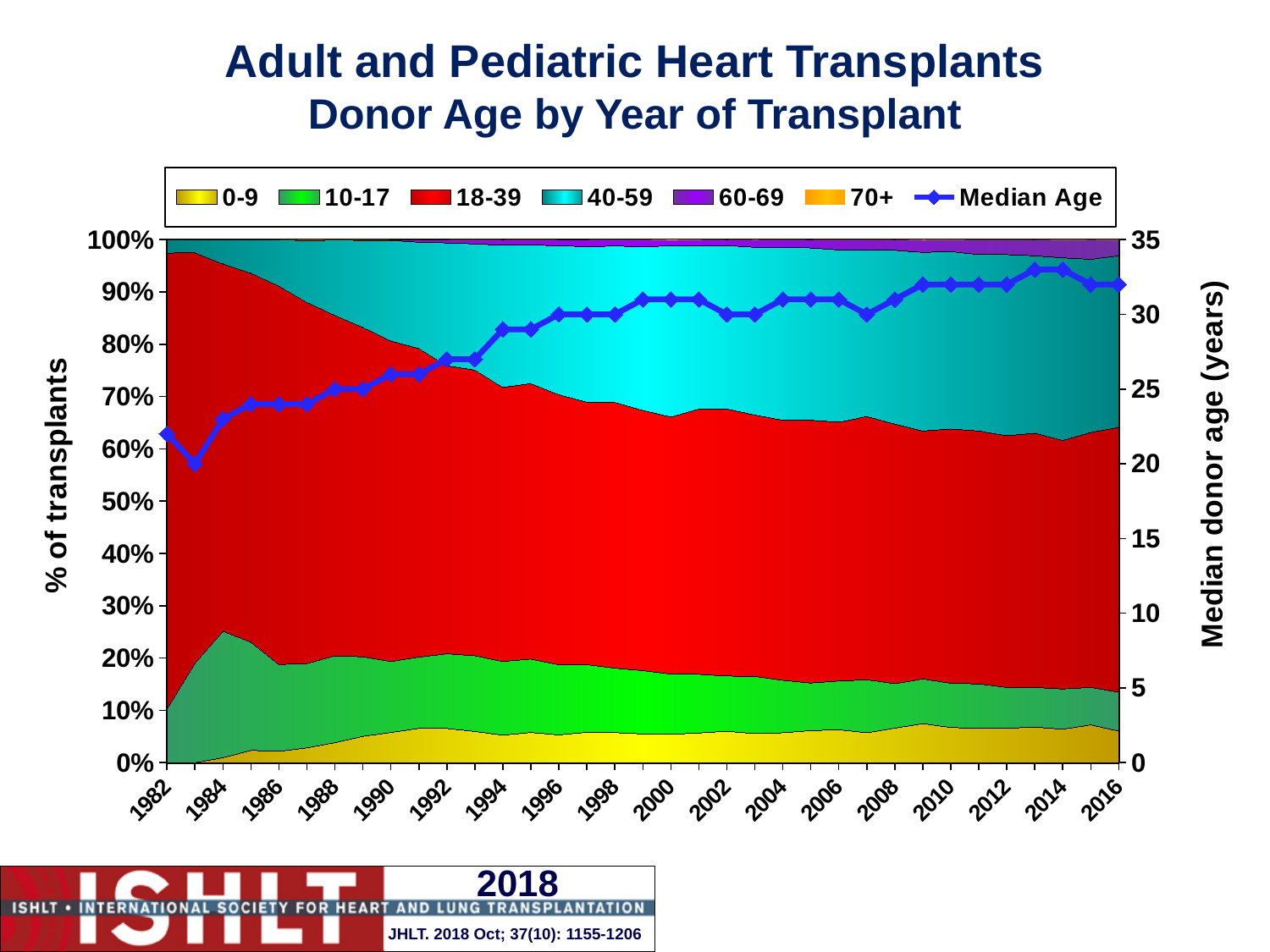
Which donor age group accounts for the largest share of transplants in 2016? 18-39 How many series does the legend list? 7 Is the Median Age in 2014 greater or less than 30 years? greater Does the Median Age line generally rise or fall from 1982 to 2016? Rise Is the share of transplants from 18-39 donors in 1982 greater or less than 80%? greater In which year is the Median Age at its lowest? 1983 What is the label of the right-hand vertical axis? Median donor age (years) What is the title of the chart? Adult and Pediatric Heart Transplants Donor Age by Year of Transplant What type of chart is shown on the slide? Stacked area chart with a line overlay Is the Median Age in 1982 greater or less than 25 years? less Which is larger, the Median Age in 2016 or in 1982? 2016